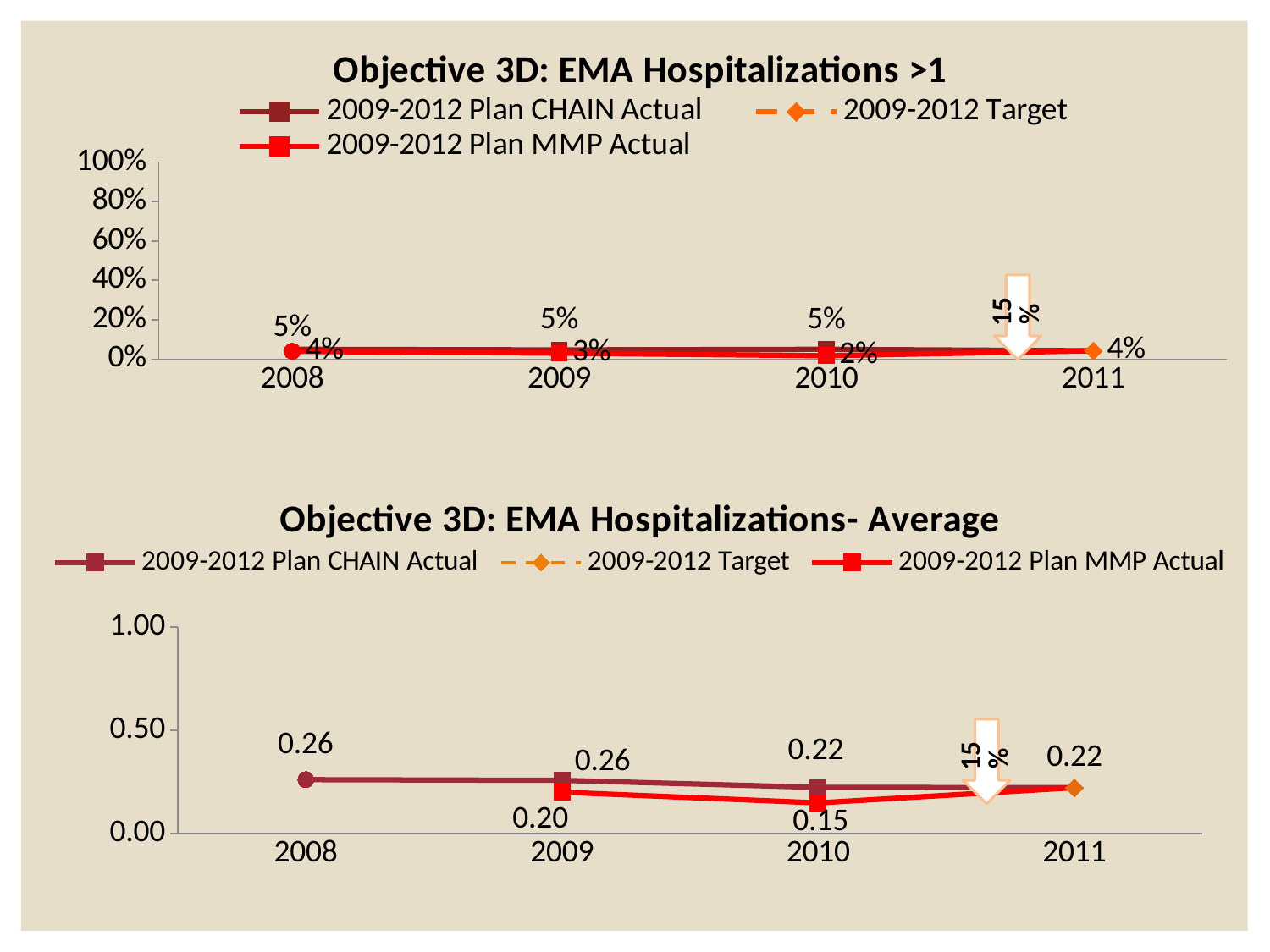
What kind of chart is the top chart, 'Objective 3D: EMA Hospitalizations >1'? Line chart In the bottom chart, 'Objective 3D: EMA Hospitalizations- Average', what is the value for 2009-2012 Plan CHAIN Actual in 2008? 0.26 In the top chart, 'Objective 3D: EMA Hospitalizations >1', what is the value for 2009-2012 Plan MMP Actual in 2010? 2% In the top chart, 'Objective 3D: EMA Hospitalizations >1', is the value for 2009-2012 Plan CHAIN Actual in 2009 greater or less than 20%? less In the top chart, 'Objective 3D: EMA Hospitalizations >1', what is the value for 2009-2012 Plan CHAIN Actual in 2009? 5% In the bottom chart, 'Objective 3D: EMA Hospitalizations- Average', what is the value for 2009-2012 Plan MMP Actual in 2010? 0.15 In the bottom chart, 'Objective 3D: EMA Hospitalizations- Average', what is the difference between the CHAIN Actual and MMP Actual values in 2009? 0.06 In the bottom chart, 'Objective 3D: EMA Hospitalizations- Average', which series has the larger value in 2010, CHAIN Actual or MMP Actual? 2009-2012 Plan CHAIN Actual How many years are shown on the x axis of the bottom chart, 'Objective 3D: EMA Hospitalizations- Average'? 4 In the top chart, 'Objective 3D: EMA Hospitalizations >1', what is the difference between the CHAIN Actual and MMP Actual values in 2010? 3% In the top chart, 'Objective 3D: EMA Hospitalizations >1', how many series does the legend list? 3